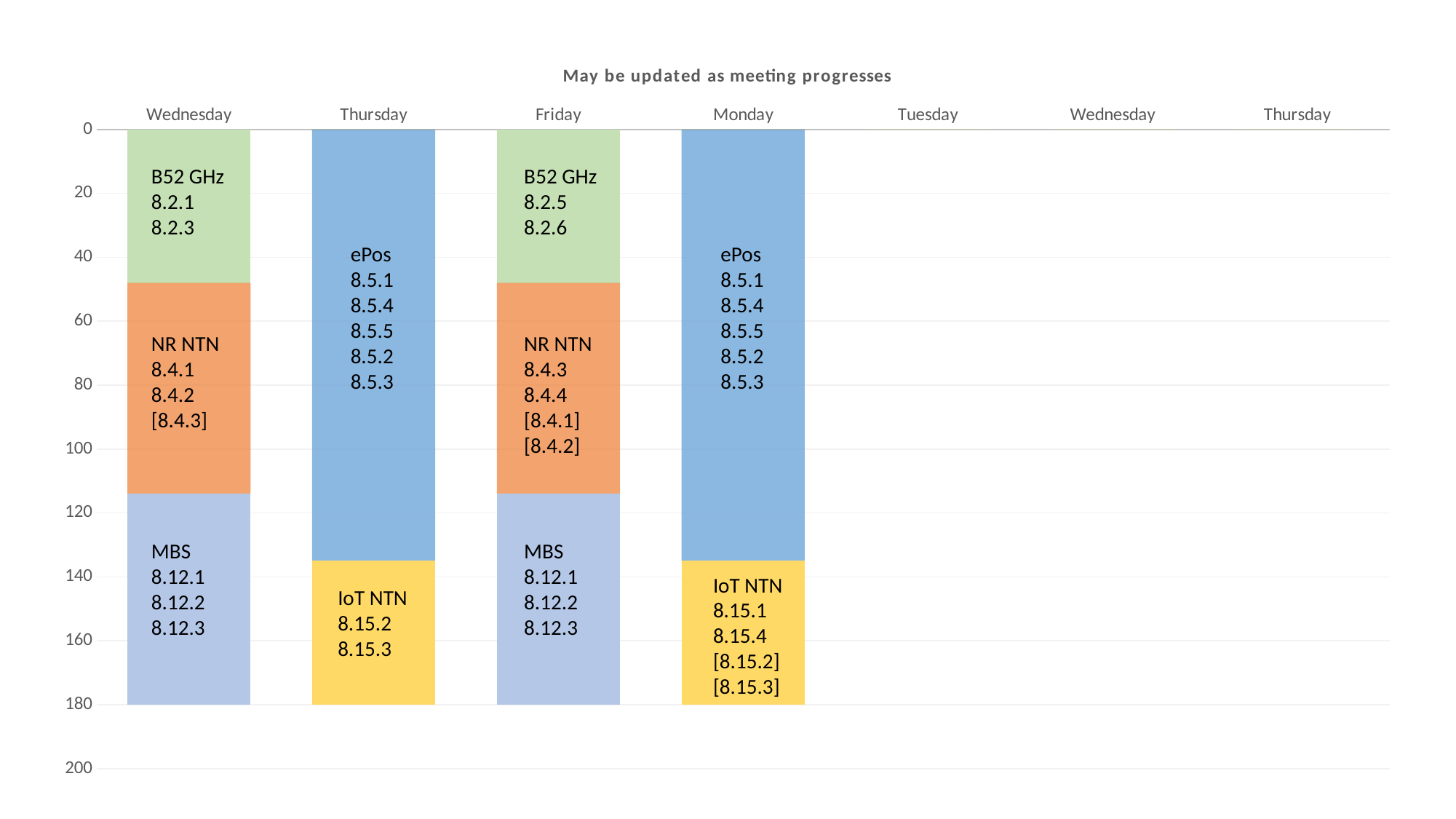
Which topic is in the yellow segment of the Thursday bar? IoT NTN At what axis value does the Wednesday bar end? 180 Which segment is the largest in the Monday bar? ePos How many of the day categories have a bar plotted? 4 Which topic occupies the top segment of the Wednesday bar? B52 GHz What kind of chart is shown on the slide? stacked bar chart Which segment is the smallest in the Wednesday bar? B52 GHz Is the value where the ePos segment of the Thursday bar ends greater or less than 140? less Which agenda items are listed in the MBS segment of the Friday bar? 8.12.1, 8.12.2, 8.12.3 How many day labels are shown along the x axis? 7 What is the title of the chart? May be updated as meeting progresses Is the value where the B52 GHz segment of the Wednesday bar ends greater or less than 40? greater